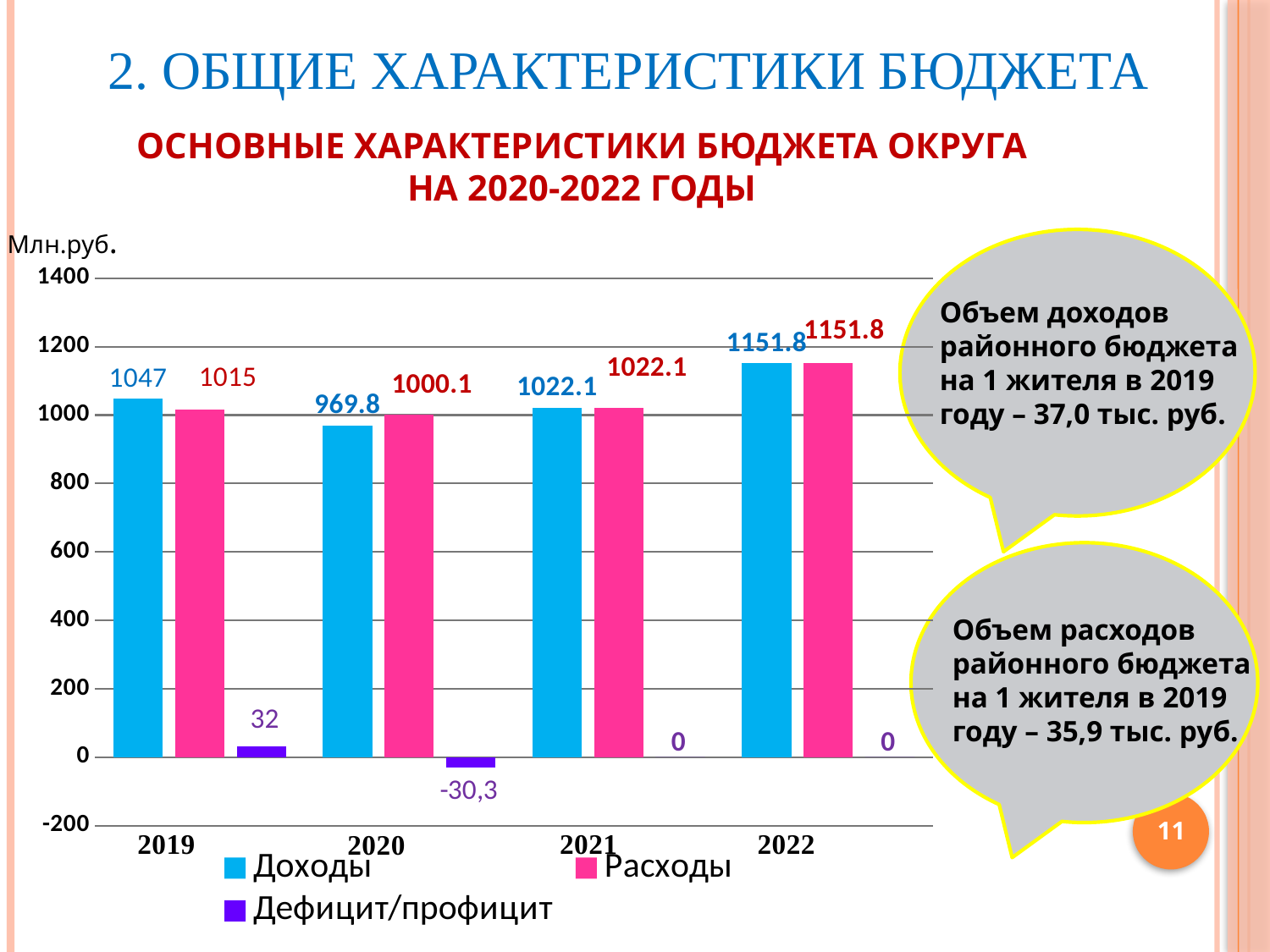
What kind of chart is shown on the slide? bar chart What is the value of Дефицит/профицит for 2020? -30,3 Which is larger in 2020, Доходы or Расходы? Расходы What unit is indicated above the vertical axis of the chart? Млн.руб. What is the difference between Доходы and Расходы in 2019? 32 What is the value of Расходы for 2022? 1151.8 What is the value of Доходы for 2019? 1047 In which year is Доходы highest? 2022 How many series does the legend list? 3 What is the value of Расходы for 2020? 1000.1 In which year is Доходы lowest? 2020 How many years are shown on the x axis? 4